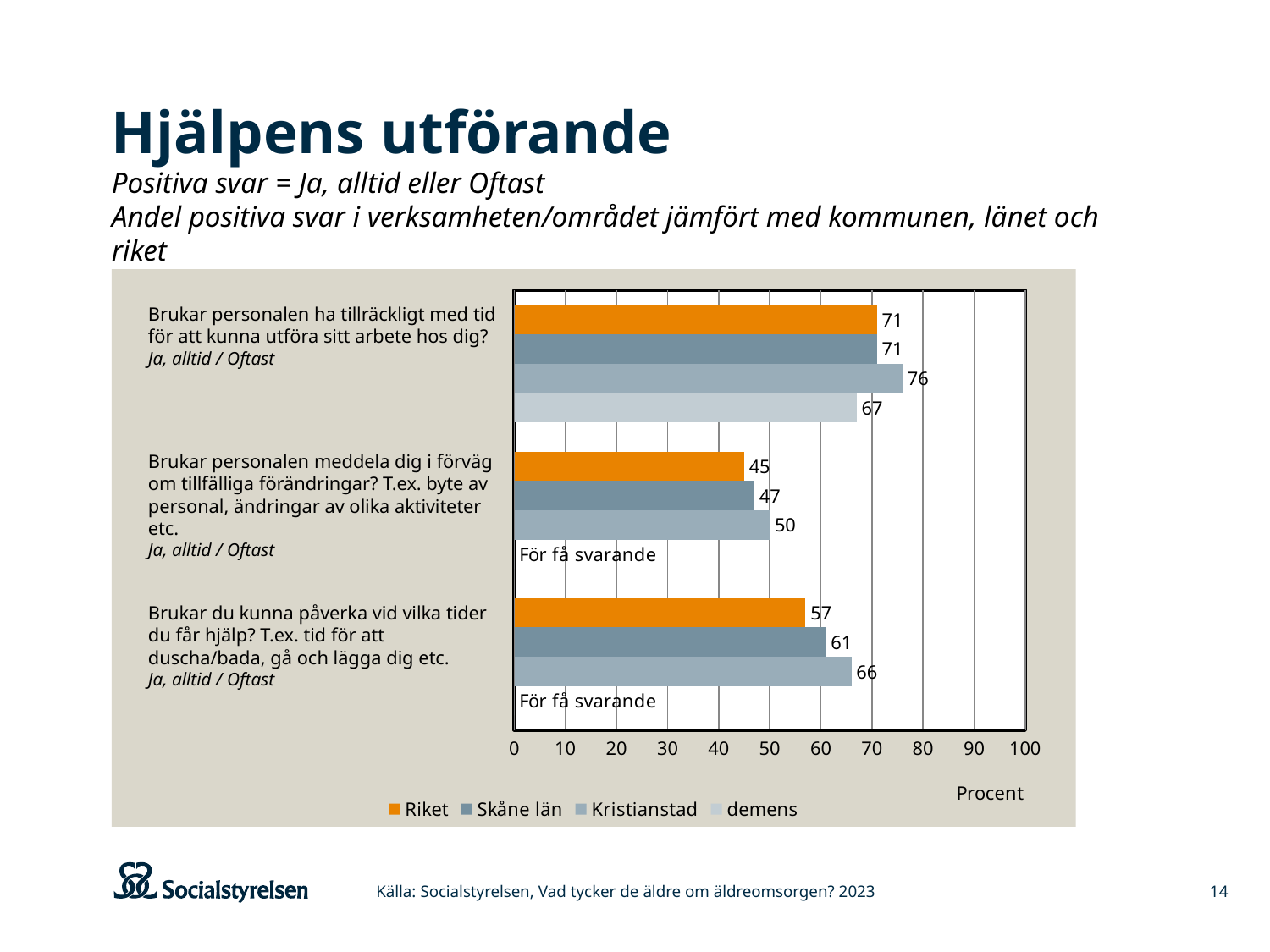
What is the value for Skåne län on the question "Brukar du kunna påverka vid vilka tider du får hjälp?"? 61 What is shown for the demens series on the question "Brukar personalen meddela dig i förväg om tillfälliga förändringar?"? För få svarande What is the label of the x axis? Procent Which series has the lowest value on the question "Brukar personalen ha tillräckligt med tid för att kunna utföra sitt arbete hos dig?"? demens What is the difference between Kristianstad and Riket on the question "Brukar du kunna påverka vid vilka tider du får hjälp?"? 9 What is the value for Kristianstad on the question "Brukar personalen ha tillräckligt med tid för att kunna utföra sitt arbete hos dig?"? 76 How many series does the legend list? 4 Which is larger on the question "Brukar personalen meddela dig i förväg om tillfälliga förändringar?": Skåne län or Kristianstad? Kristianstad What kind of chart is shown on the slide? bar chart What is the value for demens on the question "Brukar personalen ha tillräckligt med tid för att kunna utföra sitt arbete hos dig?"? 67 What is the value for Riket on the question "Brukar personalen meddela dig i förväg om tillfälliga förändringar?"? 45 Which series has the highest value on the question "Brukar du kunna påverka vid vilka tider du får hjälp?"? Kristianstad